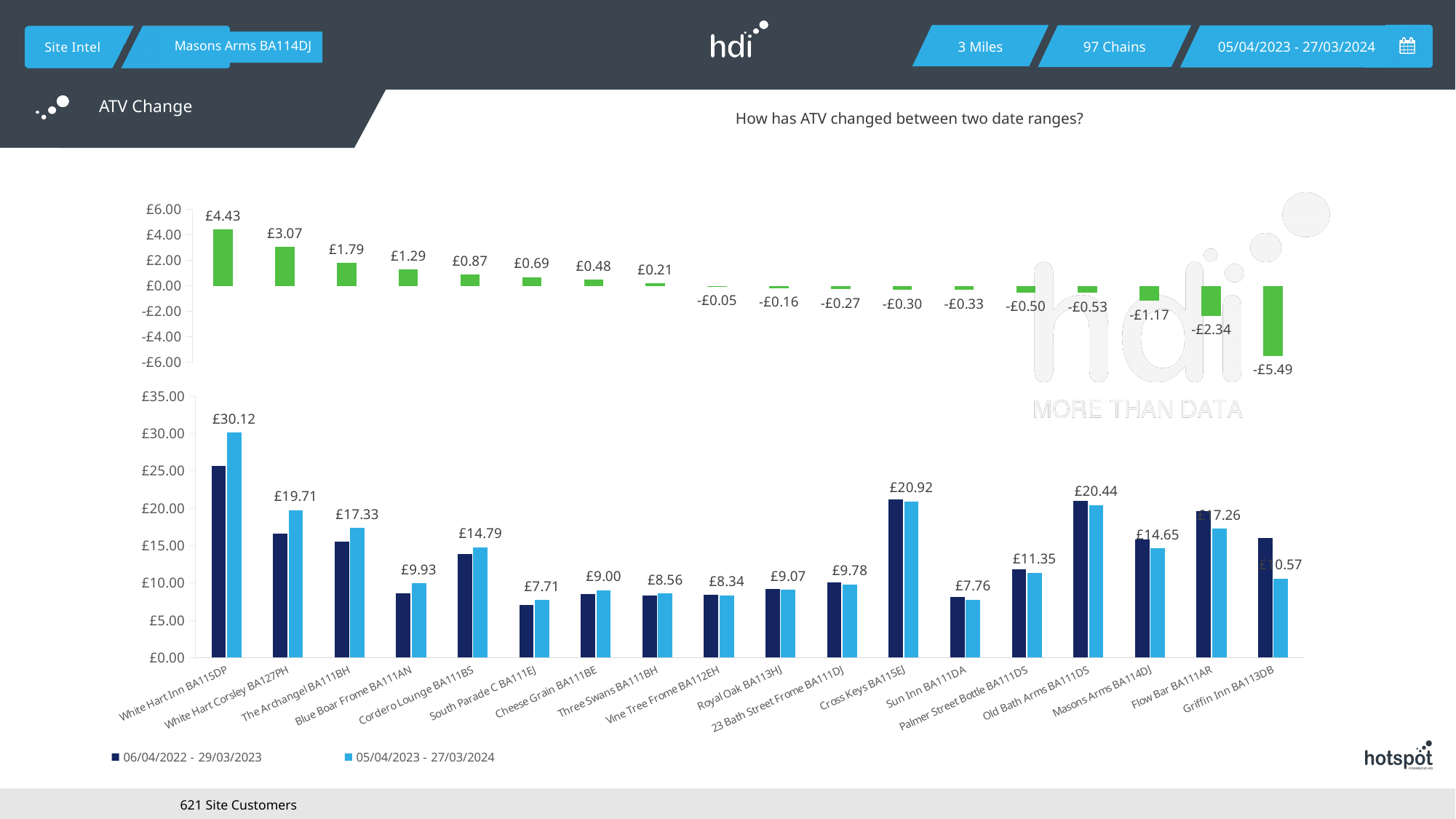
On the bottom chart, which is larger for the 05/04/2023 - 27/03/2024 series: Cross Keys BA115EJ or Old Bath Arms BA111DS? Cross Keys BA115EJ On the top chart (ATV change), which site has the lowest value? Griffin Inn BA113DB On the top chart (ATV change), what is the value for White Hart Inn BA115DP? £4.43 On the bottom chart, what is the 05/04/2023 - 27/03/2024 value for Cross Keys BA115EJ? £20.92 On the bottom chart, which site has the highest 05/04/2023 - 27/03/2024 value? White Hart Inn BA115DP On the top chart (ATV change), what is the value for Griffin Inn BA113DB? -£5.49 On the top chart (ATV change), which site has the highest value? White Hart Inn BA115DP On the top chart (ATV change), what is the difference between the values for White Hart Inn BA115DP and White Hart Corsley BA127PH? £1.36 On the top chart (ATV change), do the values rise or fall moving from left to right along the x axis? fall How many sites are shown along the x axis of the bottom chart? 18 On the bottom chart, is the 06/04/2022 - 29/03/2023 value for Cross Keys BA115EJ greater or less than £20.00? greater How many series does the legend of the bottom chart list? 2